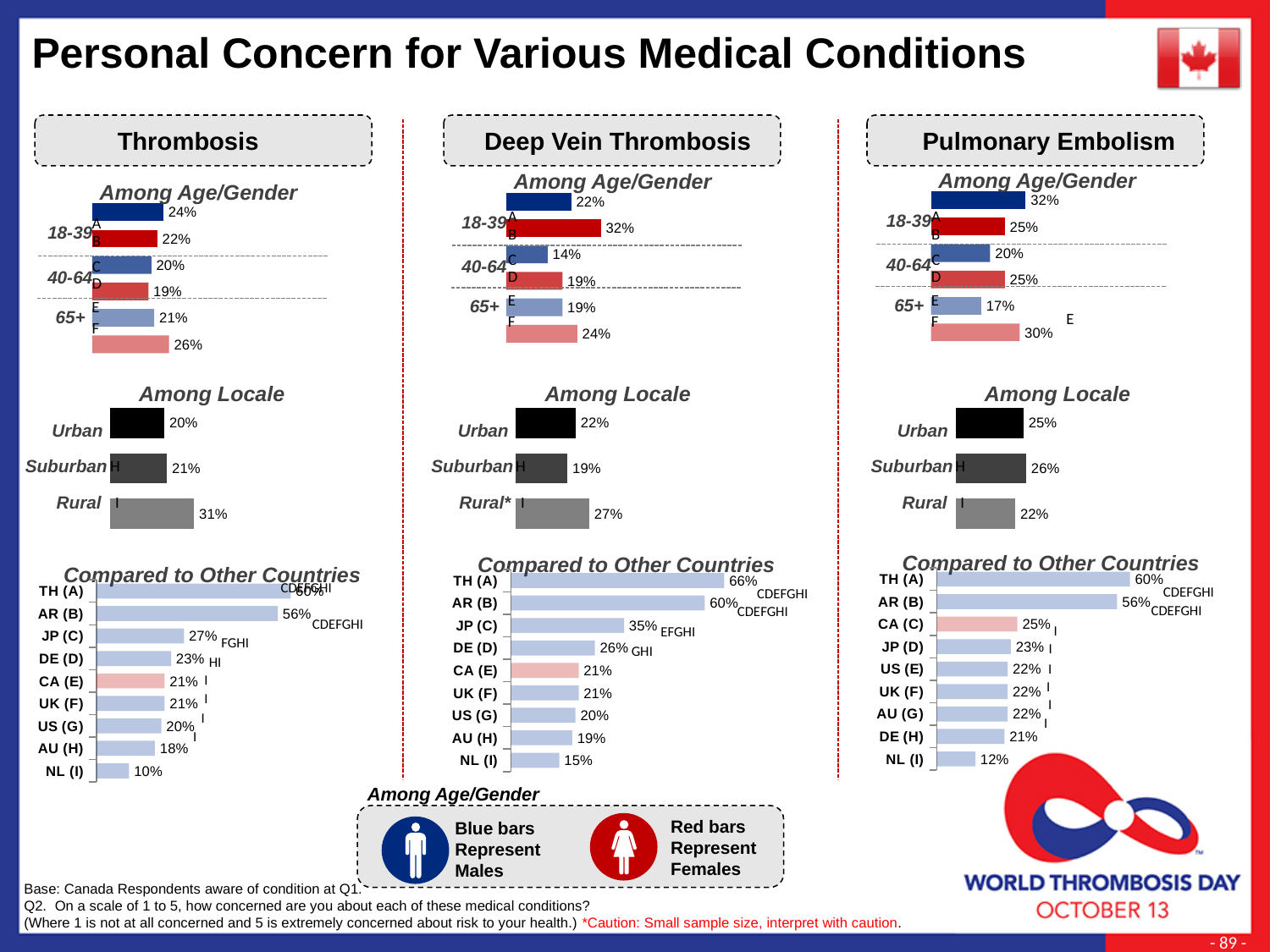
In the Deep Vein Thrombosis 'Compared to Other Countries' chart, do the values rise or fall going from TH (A) down to NL (I)? Fall In the Deep Vein Thrombosis 'Among Age/Gender' chart, what is the value for the 18-39 female bar (B)? 32% In the Deep Vein Thrombosis 'Among Locale' chart, what is the difference between the Rural* and Suburban values? 8% In the Pulmonary Embolism 'Among Locale' chart, what is the difference between the Suburban and Rural values? 4% In the Pulmonary Embolism 'Among Age/Gender' chart, which is larger: the 18-39 male bar (A) or the 65+ female bar (F)? 18-39 male bar (A) How many countries are listed in the Thrombosis 'Compared to Other Countries' chart? 9 In the Deep Vein Thrombosis 'Compared to Other Countries' chart, which country has the lowest value? NL (I) In the Pulmonary Embolism 'Compared to Other Countries' chart, what is the value for CA (C)? 25% According to the legend at the bottom of the slide, what do the red bars in the 'Among Age/Gender' charts represent? Females In the Thrombosis 'Compared to Other Countries' chart, which country has the highest value? TH (A) What type of chart is the Pulmonary Embolism 'Among Locale' chart? Bar chart In the Thrombosis 'Among Locale' chart, what is the value for Rural? 31%